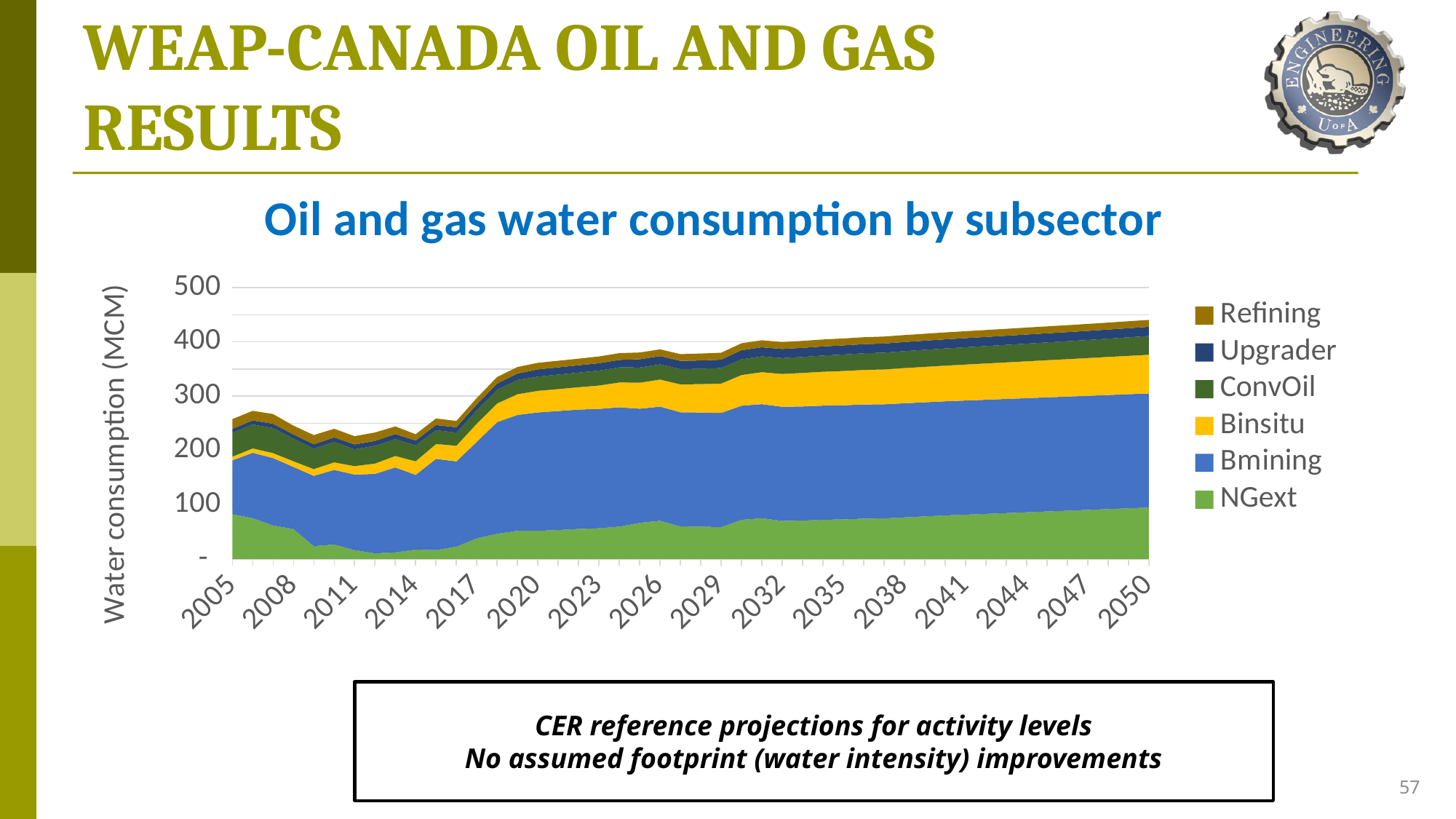
Which is larger in 2050, the water consumption of Bmining or of NGext? Bmining What is the title of the chart? Oil and gas water consumption by subsector Is the total water consumption in 2005 greater or less than 300? less What is the label on the vertical axis of the chart? Water consumption (MCM) How many series does the legend list? 6 Is the total water consumption in 2050 greater or less than 400? greater Is the total water consumption in 2011 greater or less than 300? less Which is larger, the total water consumption in 2050 or in 2005? 2050 What kind of chart is shown on the slide? Stacked area chart Does total oil and gas water consumption rise or fall overall from 2005 to 2050? Rise Which subsector contributes the largest share of water consumption in 2050? Bmining